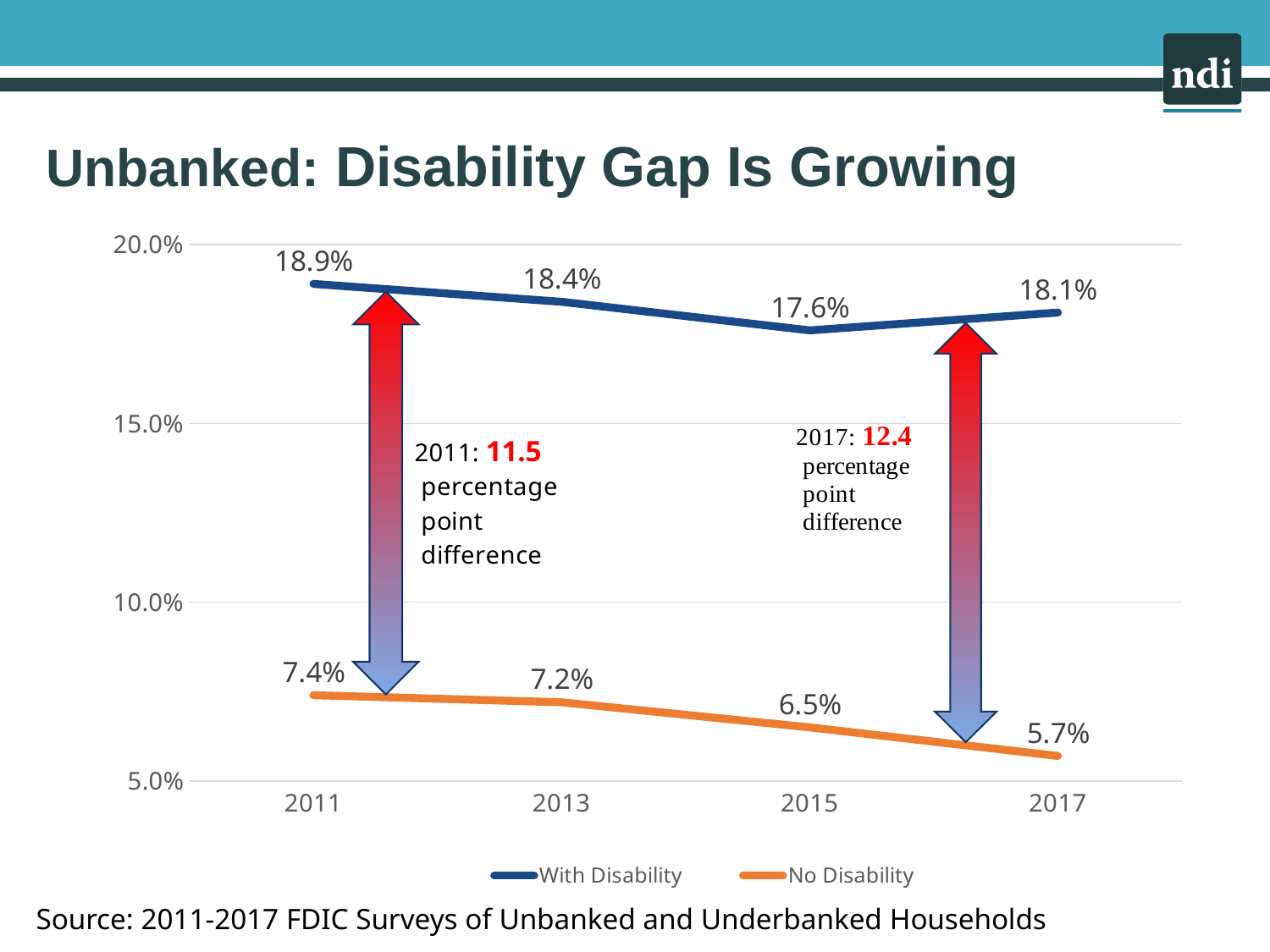
What is the difference between the No Disability values in 2011 and 2017? 1.7 percentage points In which year is the No Disability value lowest? 2017 What kind of chart is shown on the slide? Line chart Which is larger in 2013: the With Disability value or the No Disability value? With Disability What is the difference between the With Disability and No Disability values in 2017? 12.4 percentage points In which year is the With Disability value highest? 2011 What is the unbanked rate for No Disability in 2017? 5.7% What is the unbanked rate for With Disability in 2011? 18.9% Is the With Disability value in 2015 greater or less than 15.0%? greater What is the value for With Disability in 2015? 17.6% How many series does the legend list? 2 How many years are shown on the x axis? 4